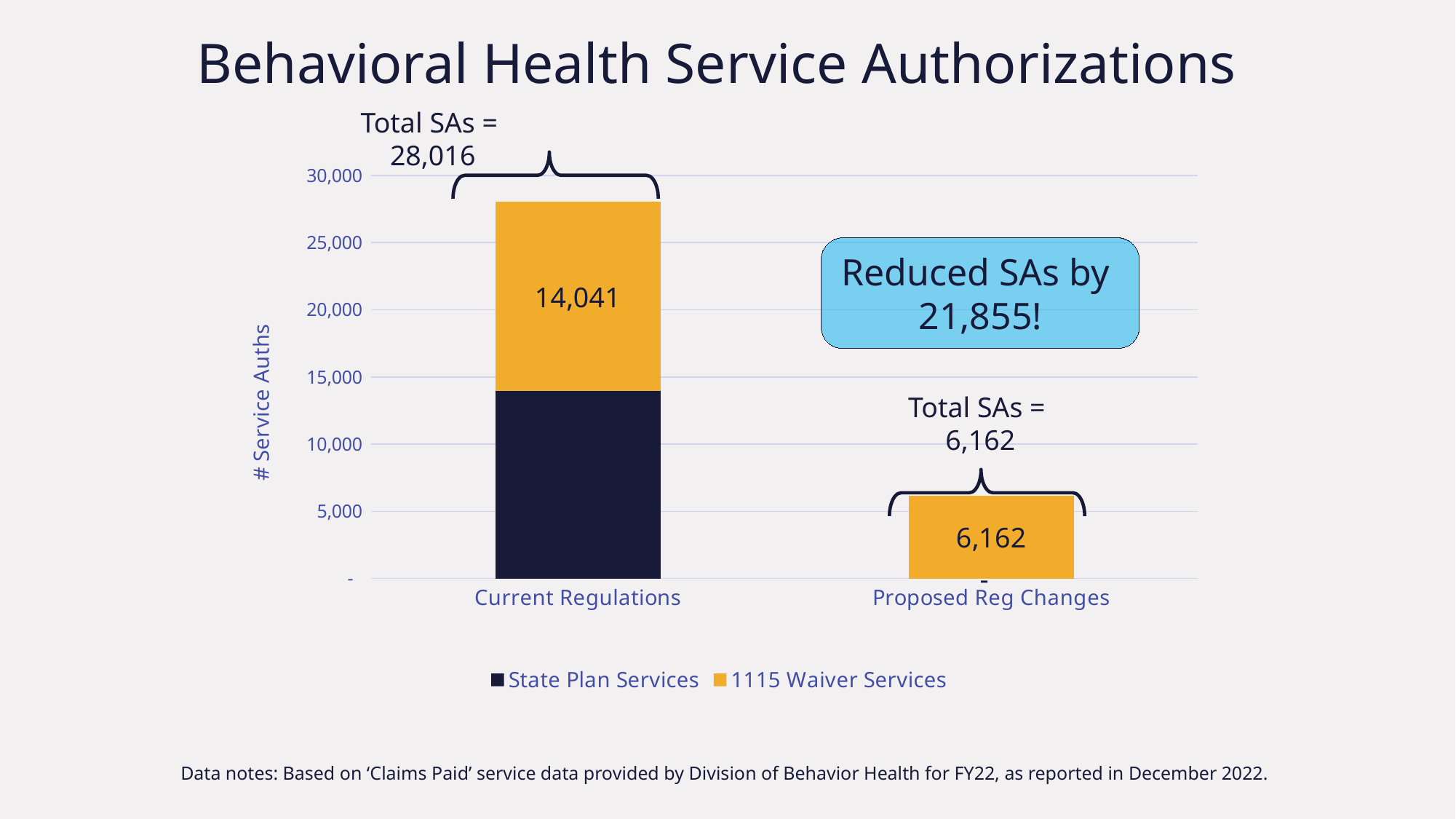
What is the difference between the 1115 Waiver Services values for Current Regulations and Proposed Reg Changes? 7,879 Which category has the highest total number of service authorizations? Current Regulations How many series does the legend list? 2 Which category has the larger 1115 Waiver Services value, Current Regulations or Proposed Reg Changes? Current Regulations Is the value for State Plan Services under Current Regulations greater or less than 10,000? greater What is the total number of service authorizations for the Proposed Reg Changes bar? 6,162 What is the total number of service authorizations for the Current Regulations bar? 28,016 What kind of chart is shown on the slide? bar chart What is the value of 1115 Waiver Services under Proposed Reg Changes? 6,162 What is the value of 1115 Waiver Services under Current Regulations? 14,041 How many categories are shown on the x axis? 2 By how much is the total of Current Regulations greater than the total of Proposed Reg Changes? 21,855